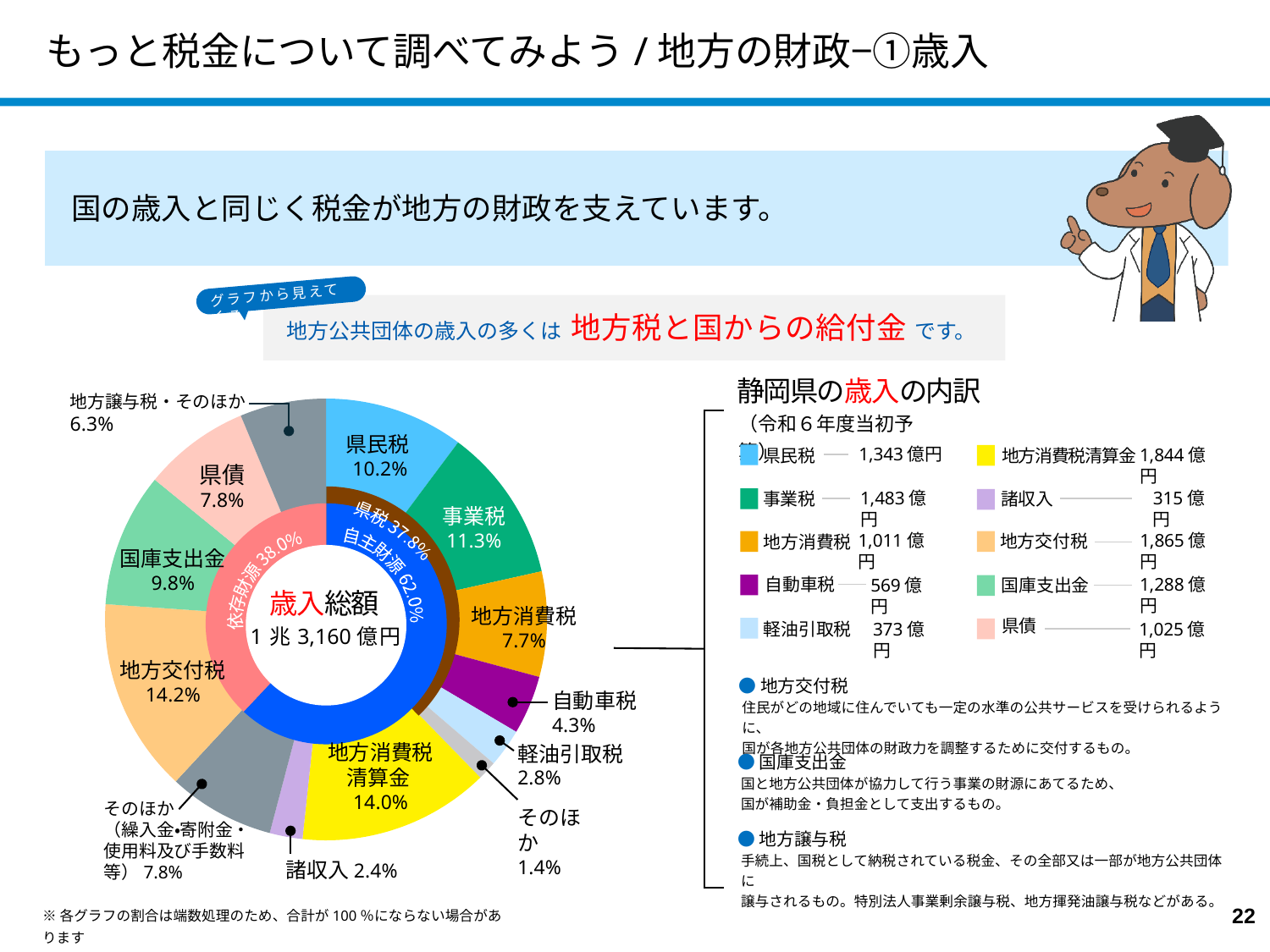
凡例に示されている地方交付税の金額はいくらですか。 1,865億円 グラフの中央に示されている歳入総額はいくらですか。 1兆3,160億円 グラフの右側に示されているタイトルは何ですか。 静岡県の歳入の内訳 外側の円で最も割合が大きい項目はどれですか。 地方交付税（14.2%） 地方交付税の割合は何％ですか。 14.2% 国庫支出金と県債では、どちらの割合が大きいですか。 国庫支出金 内側の円に示されている自主財源の割合は何％ですか。 62.0% このグラフはどの種類のグラフですか。 円グラフ（ドーナツグラフ） 事業税と県民税の割合の差は何ポイントですか。 1.1ポイント 地方消費税清算金の割合は何％ですか。 14.0% 内側の円に示されている依存財源の割合は何％ですか。 38.0% 外側の円で最も割合が小さい項目はどれですか。 そのほか（1.4%）